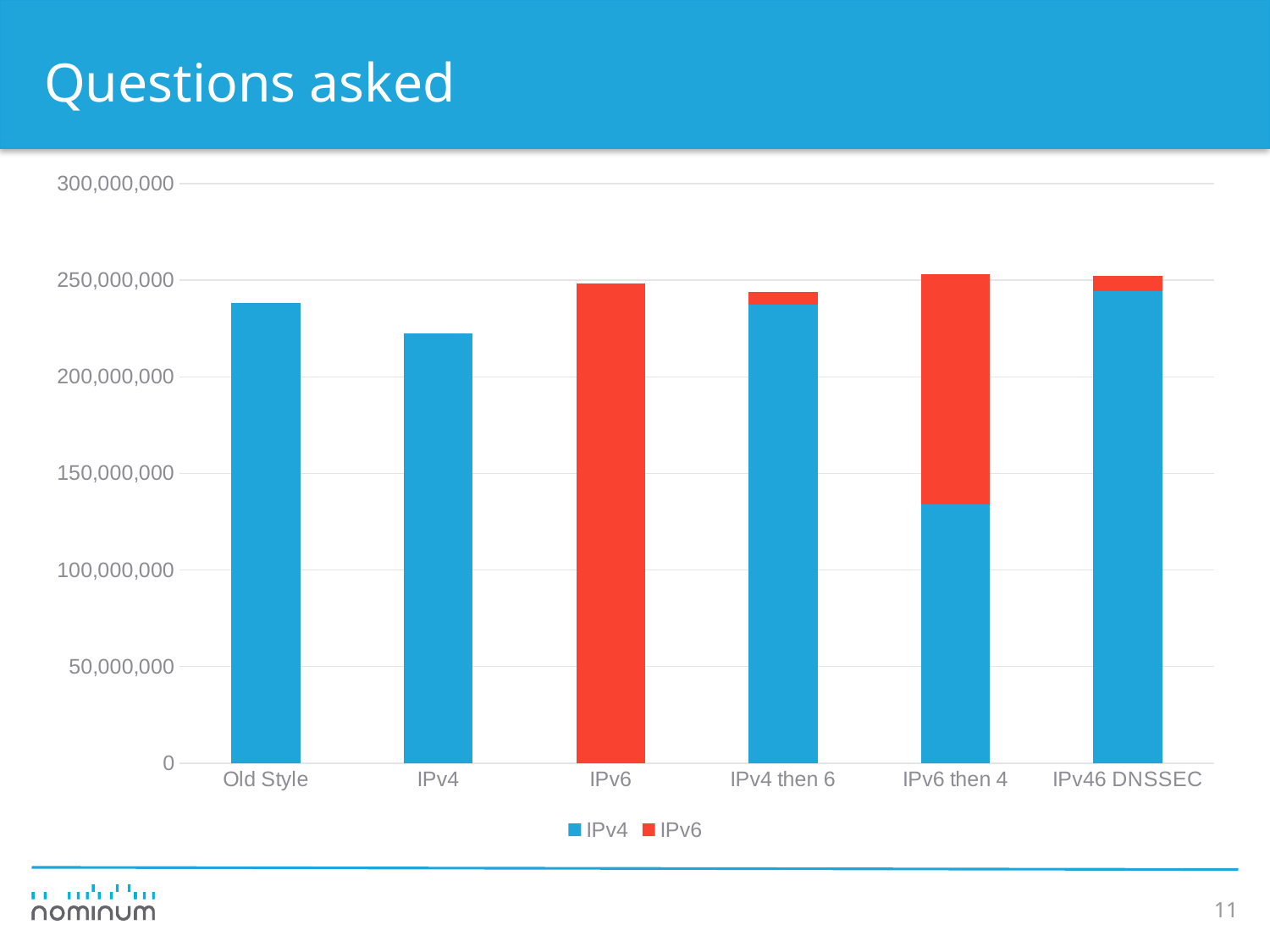
Which category has the lowest total bar? IPv4 What kind of chart is shown on the slide? Stacked bar chart Which is larger, the bar for Old Style or the bar for IPv4? Old Style Is the total for the IPv4 category greater or less than 250,000,000? less How many series does the legend list? 2 Which has the larger IPv6 portion, IPv4 then 6 or IPv6 then 4? IPv6 then 4 Which category's bar consists only of the IPv6 series? IPv6 Is the IPv4 portion of the IPv6 then 4 bar greater or less than 150,000,000? less How many categories are shown on the x axis? 6 Is the value for Old Style greater or less than 200,000,000? greater Which category has the largest IPv6 portion? IPv6 What is the title of the slide containing the chart? Questions asked